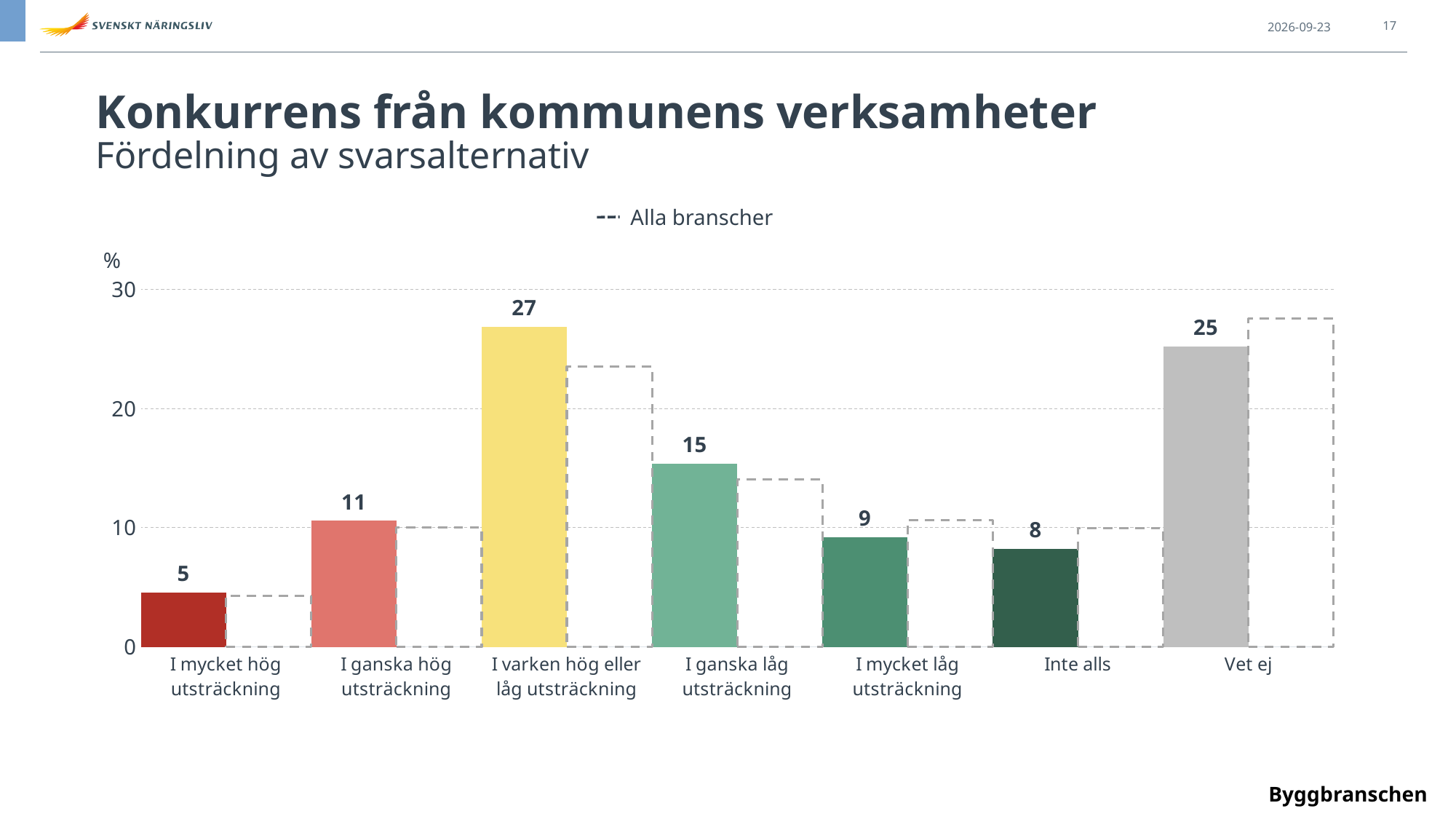
What is the value for "I mycket hög utsträckning"? 5 Which is larger, the value for "I ganska hög utsträckning" or the value for "I ganska låg utsträckning"? I ganska låg utsträckning What kind of chart is shown on the slide? Bar chart How many entries does the legend list? 1 What is the legend entry shown above the chart? Alla branscher Which category has the highest value? I varken hög eller låg utsträckning How many categories are shown on the x axis? 7 What is the value for "Vet ej"? 25 What is the value for "I varken hög eller låg utsträckning"? 27 Which category has the lowest value? I mycket hög utsträckning What is the difference between the values for "I varken hög eller låg utsträckning" and "Vet ej"? 2 Is the dashed "Alla branscher" value for "Vet ej" greater or less than 25? greater